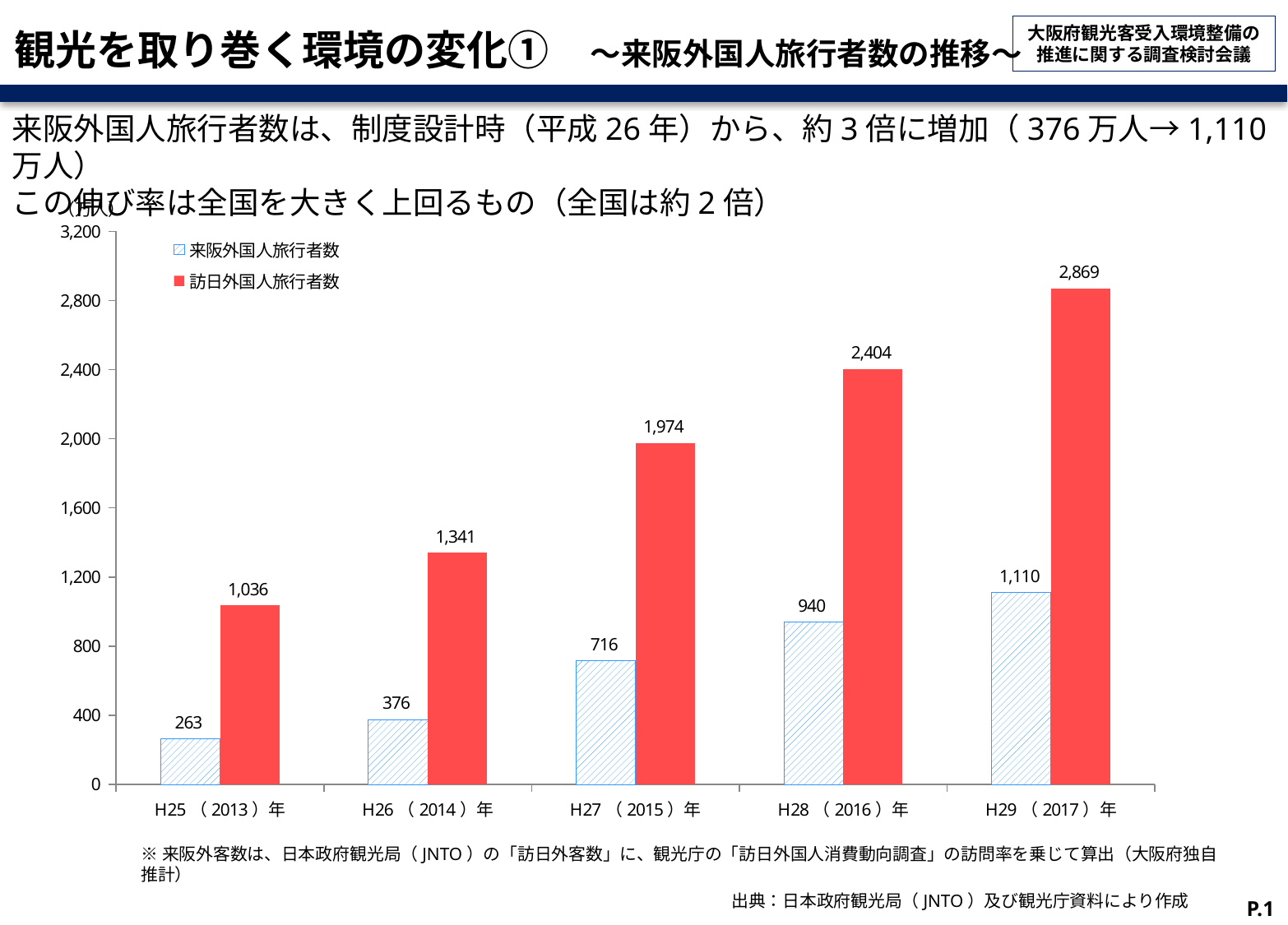
What is the value of 訪日外国人旅行者数 for H29（2017）年? 2,869 Which year has the lowest value for 来阪外国人旅行者数? H25（2013）年 What is the value of 来阪外国人旅行者数 for H26（2014）年? 376 How many years are shown on the x axis? 5 What is the value of 来阪外国人旅行者数 for H27（2015）年? 716 How many series does the legend list? 2 Which is larger: 来阪外国人旅行者数 in H29（2017）年 or 訪日外国人旅行者数 in H25（2013）年? 来阪外国人旅行者数 in H29（2017）年 What kind of chart is shown on the slide? bar chart Is the value of 訪日外国人旅行者数 for H27（2015）年 greater or less than 1,600? greater Do the values of 来阪外国人旅行者数 rise or fall from H25（2013）年 to H29（2017）年? rise Which year has the highest value for 訪日外国人旅行者数? H29（2017）年 What is the difference between 訪日外国人旅行者数 and 来阪外国人旅行者数 in H28（2016）年? 1,464